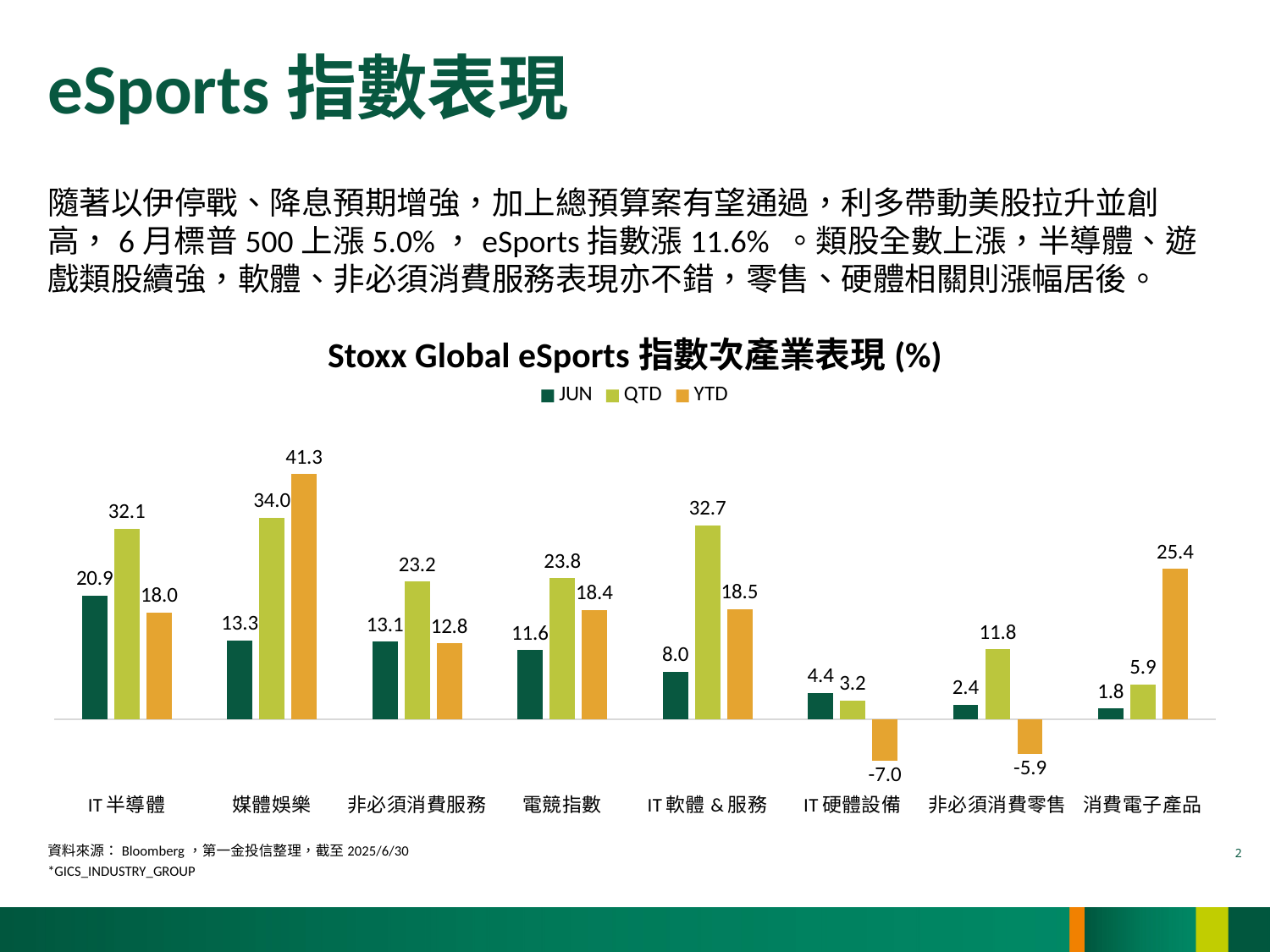
Which is larger for 電競指數, the QTD value or the YTD value? QTD How many series does the legend list? 3 What is the YTD value for IT 硬體設備? -7.0 What kind of chart is shown? Bar chart Which category has the lowest YTD value? IT 硬體設備 What is the YTD value for 媒體娛樂? 41.3 What is the difference between the YTD and JUN values for 消費電子產品? 23.6 Do the JUN values rise or fall from left to right across the categories? Fall What is the JUN value for IT 半導體? 20.9 How many categories are shown on the x axis? 8 What is the QTD value for IT 軟體 & 服務? 32.7 Which category has the highest JUN value? IT 半導體